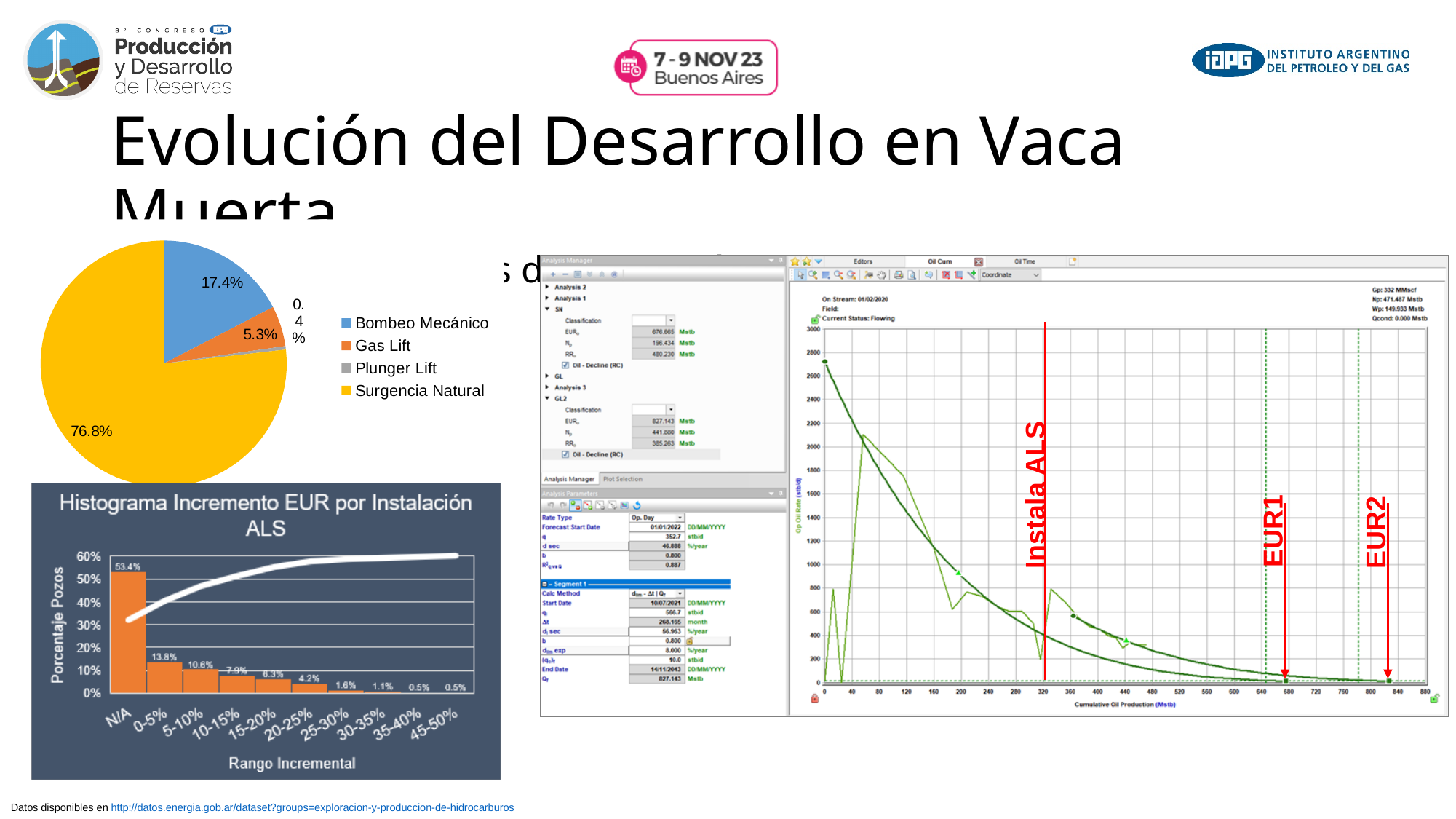
In the pie chart at the top left, what share does Surgencia Natural have? 76.8% In the pie chart at the top left, which category has the smallest slice? Plunger Lift In the chart titled 'Histograma Incremento EUR por Instalación ALS', what is the label of the y axis? Porcentaje Pozos In the chart titled 'Histograma Incremento EUR por Instalación ALS', what is the value for the 5-10% range? 10.6% In the chart titled 'Histograma Incremento EUR por Instalación ALS', which is larger, the value for 0-5% or the value for 15-20%? 0-5% What kind of chart is the plot on the right side of the slide with the 'Instala ALS' annotation? line chart In the pie chart at the top left, what is the difference between the Bombeo Mecánico and Gas Lift shares? 12.1% In the chart titled 'Histograma Incremento EUR por Instalación ALS', what is the value for the N/A category? 53.4% In the chart titled 'Histograma Incremento EUR por Instalación ALS', do the bar values rise or fall from left to right along the x axis? fall In the pie chart at the top left, how many entries does the legend list? 4 In the chart titled 'Histograma Incremento EUR por Instalación ALS', how many categories are shown on the x axis? 10 In the pie chart at the top left, what is the value for Bombeo Mecánico? 17.4%